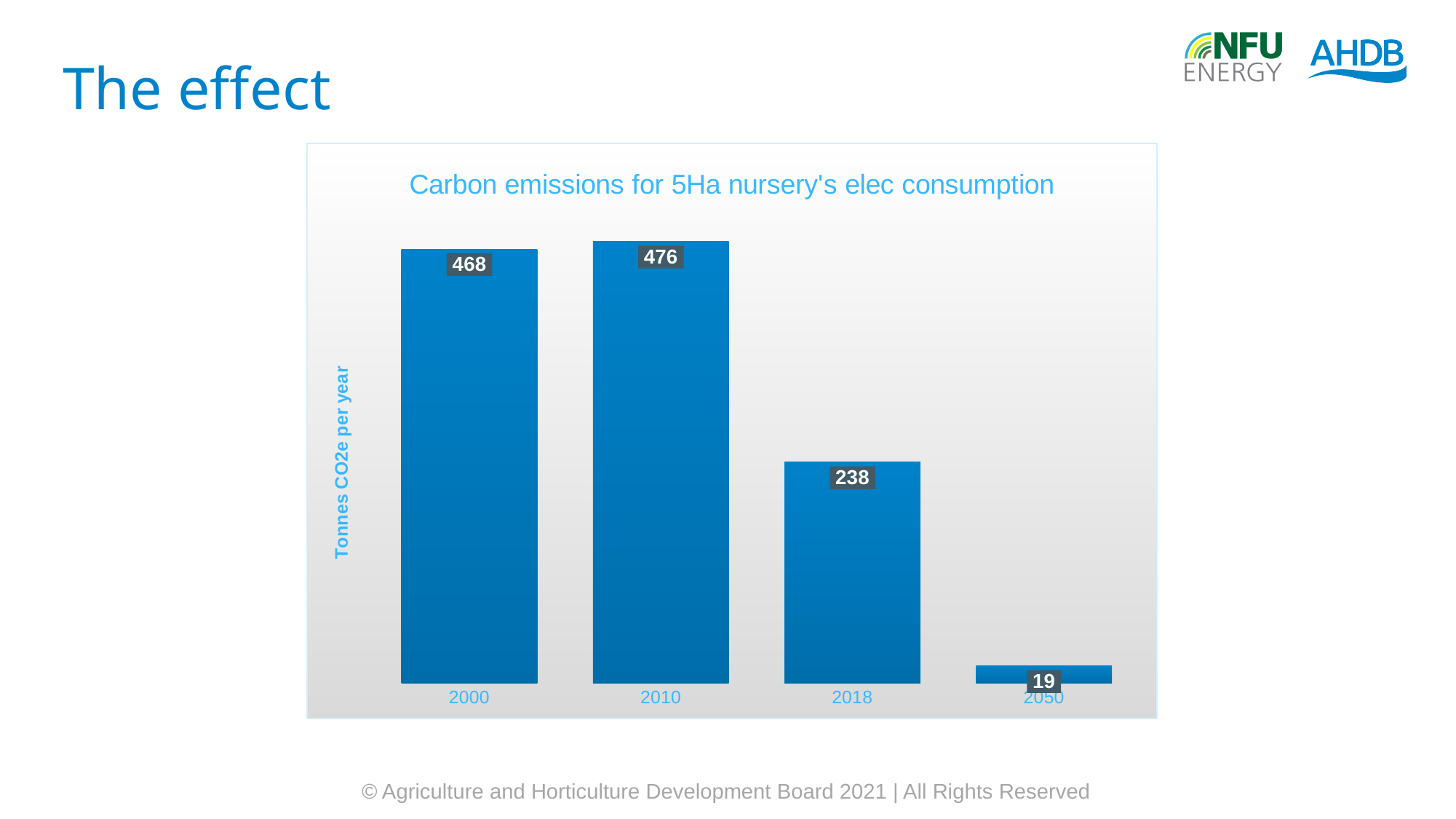
What is the difference between the values for 2010 and 2018? 238 Which is larger, the value for 2000 or the value for 2018? 2000 Which year has the lowest carbon emissions? 2050 What is the value for 2018? 238 How many years are shown on the x axis? 4 What is the value for 2000? 468 What kind of chart is this? bar chart What is the value for 2010? 476 What is the y-axis label of the chart? Tonnes CO2e per year What is the value for 2050? 19 What is the difference between the values for 2018 and 2050? 219 Which year has the highest carbon emissions? 2010